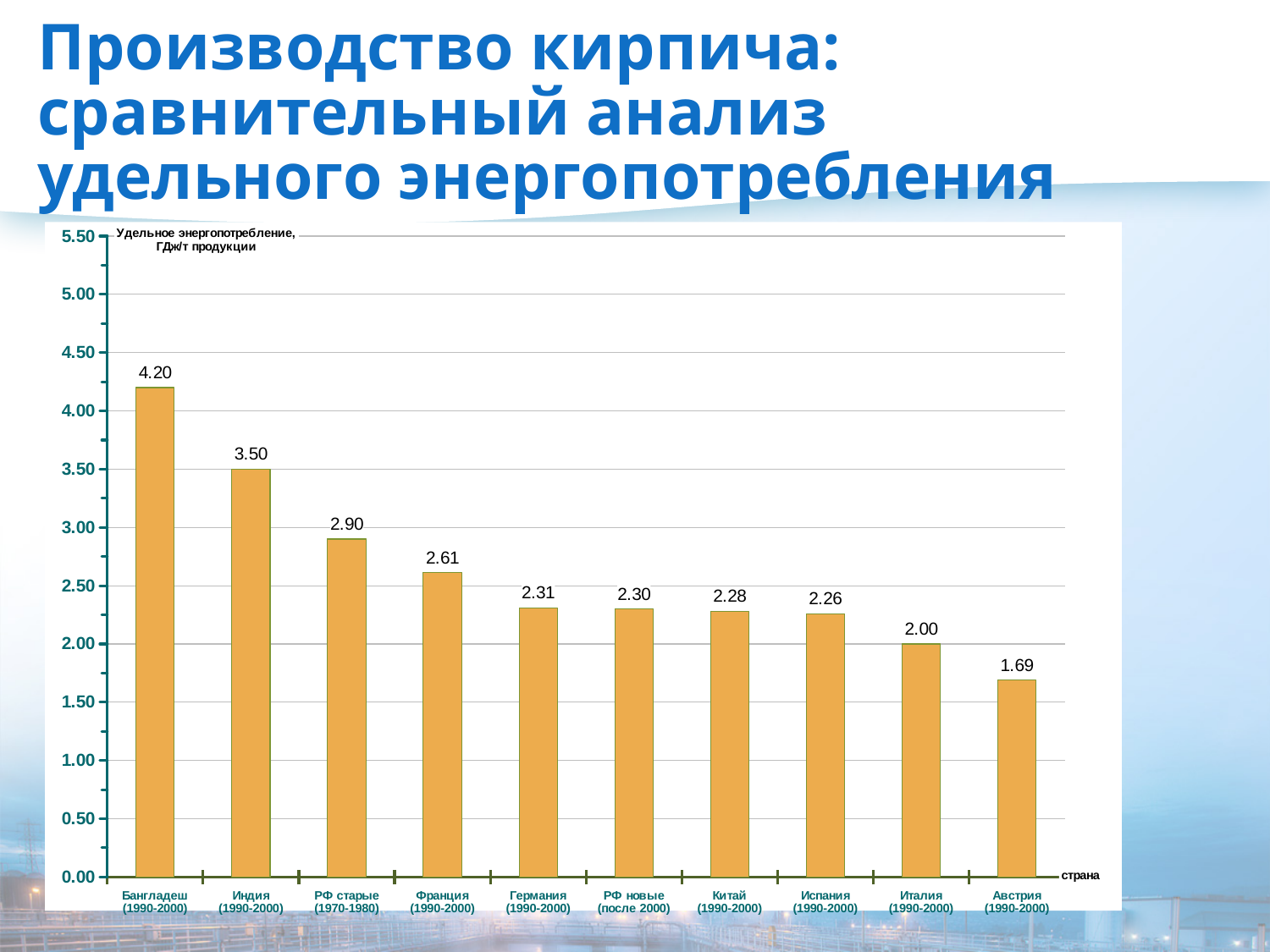
What value is shown for РФ старые (1970-1980)? 2.90 What type of chart is shown on the slide? bar chart How many countries (categories) are shown on the chart? 10 Do the values rise or fall from left to right along the x axis? fall What is the difference between the values for Индия and Италия? 1.50 Which country has the lowest specific energy consumption on the chart? Австрия Is the value for Испания greater or less than 2.50? less Which country has the highest specific energy consumption on the chart? Бангладеш Which has a larger value, Франция or Германия? Франция What is the specific energy consumption value shown for Бангладеш (1990-2000)? 4.20 What value is shown for Австрия (1990-2000)? 1.69 What unit is given for the y axis label on the chart? ГДж/т продукции